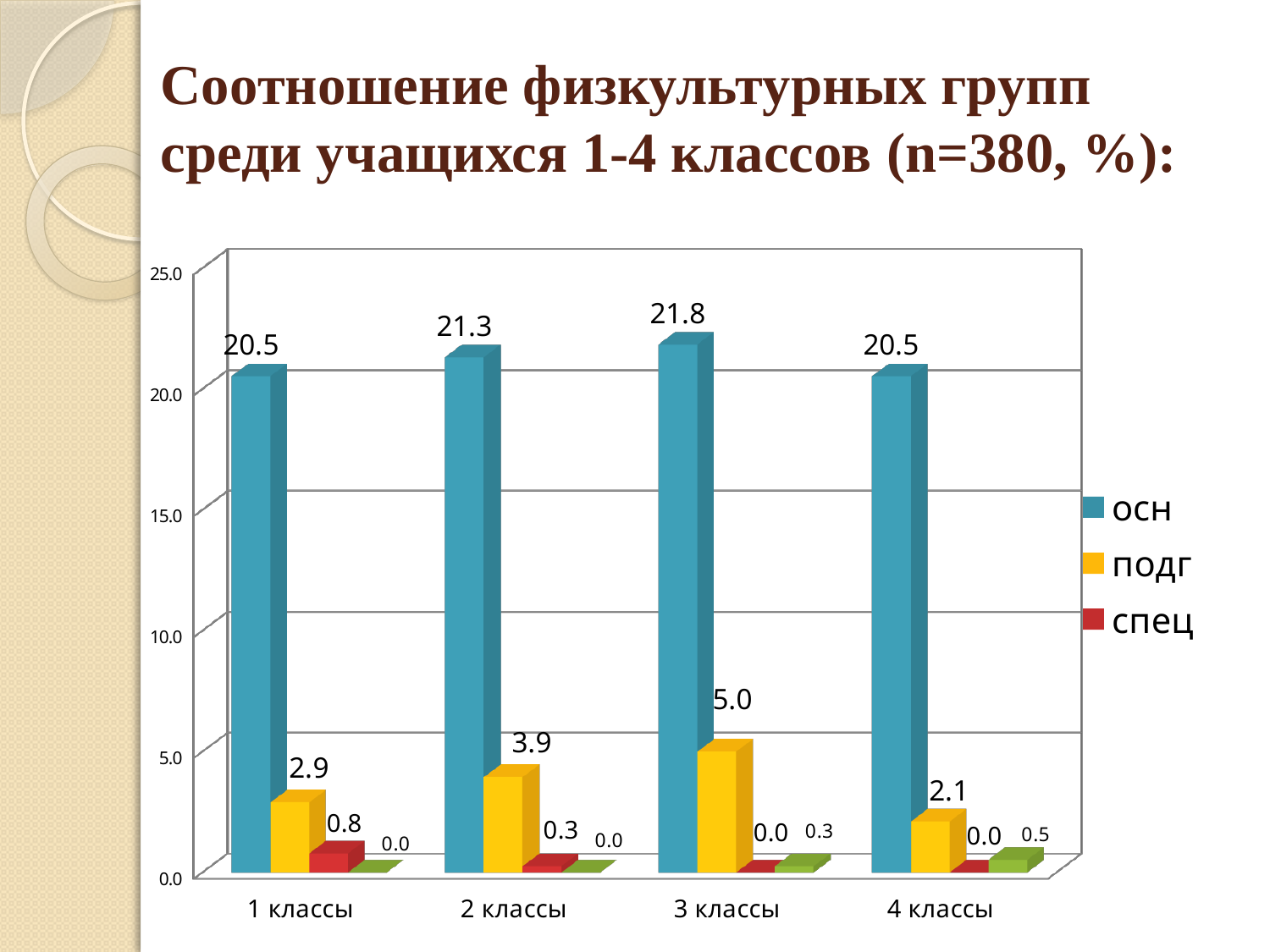
Which is larger, the подг value for 3 классы or for 2 классы? 3 классы What kind of chart is shown on the slide? bar chart What is the value for подг in 2 классы? 3.9 What is the value for спец in 1 классы? 0.8 What is the value for осн in 3 классы? 21.8 What is the difference between the осн values for 3 классы and 1 классы? 1.3 How many series does the legend list? 3 What is the title of the chart on the slide? Соотношение физкультурных групп среди учащихся 1-4 классов (n=380, %): Which class group has the lowest value for подг? 4 классы How many class groups are shown on the x axis? 4 Which class group has the highest value for осн? 3 классы What is the value for подг in 4 классы? 2.1